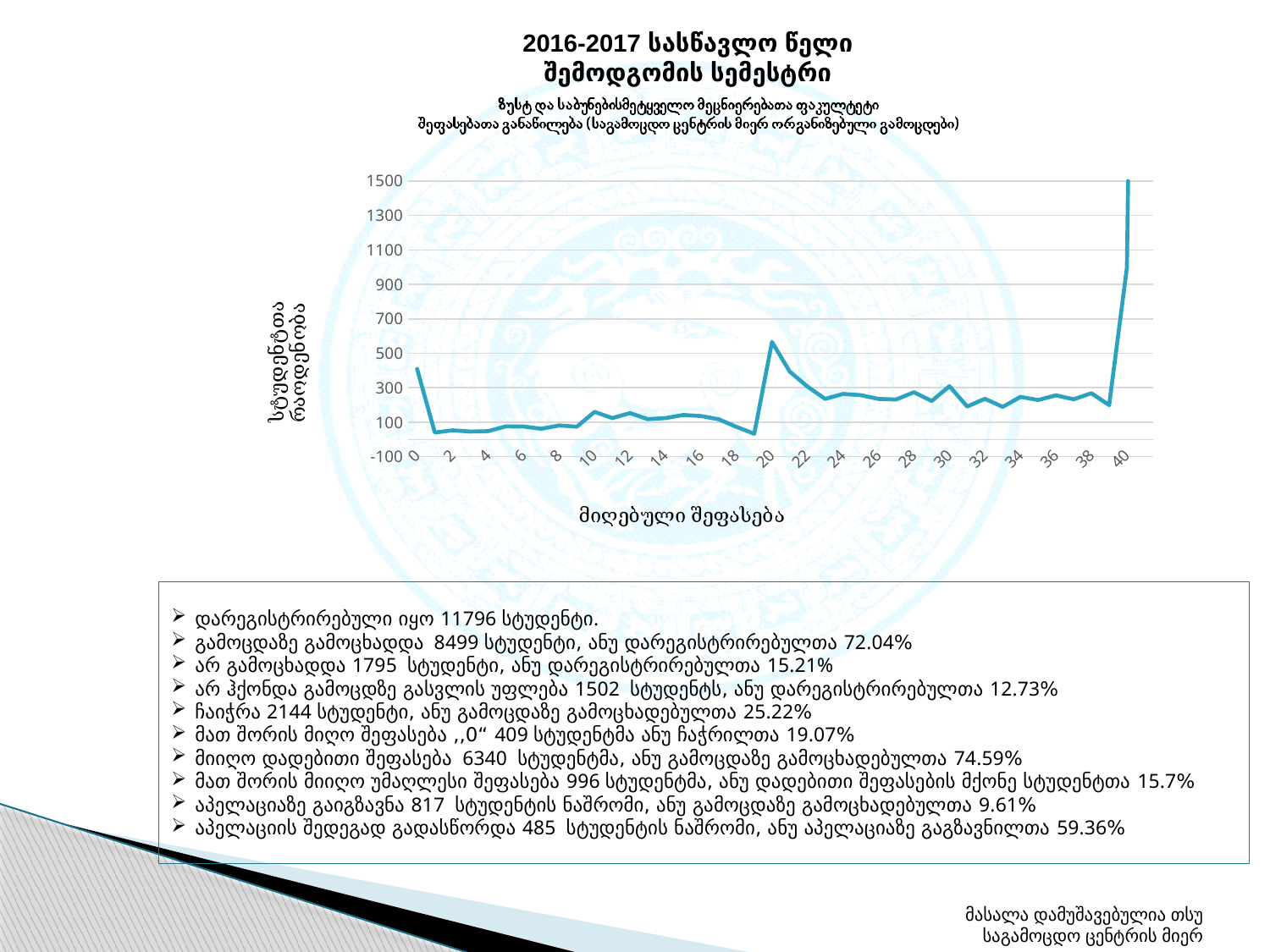
Is the value at score 10 greater or less than 300? less Is the value at score 30 greater or less than 100? greater What kind of chart is shown on the slide? line chart Which has the larger value, score 20 or score 30? score 20 Does the line rise or fall between score 20 and score 22? fall Which has the larger value, score 40 or score 20? score 40 Does the line rise or fall between score 38 and score 40? rise At which score on the x axis does the line reach its highest value? 40 What is the highest tick value shown on the y axis? 1500 Is the value at score 20 greater or less than 300? greater